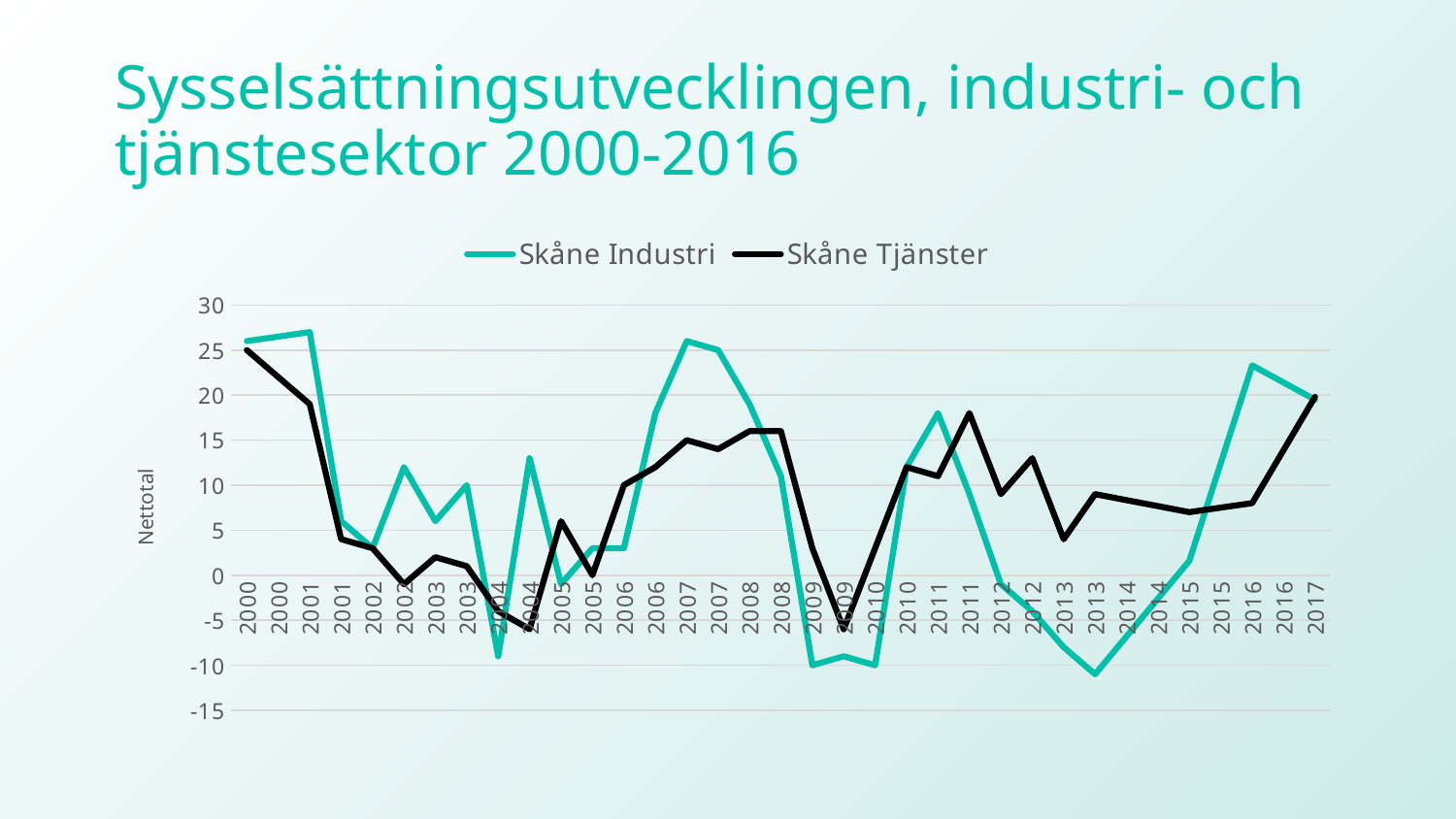
Is the value for Skåne Tjänster at the second 2004 point greater or less than 0? less At the first 2007 point, which series has the higher value, Skåne Industri or Skåne Tjänster? Skåne Industri Is the value for Skåne Tjänster at the second 2011 point greater or less than 15? greater What kind of chart is shown on the slide? line chart At the second 2013 point, which series has the higher value, Skåne Industri or Skåne Tjänster? Skåne Tjänster Is the value for Skåne Industri at the first 2007 point greater or less than 20? greater How many series does the legend list? 2 What is the title of the vertical axis? Nettotal Does the Skåne Tjänster line rise or fall from the first 2000 point to the second 2004 point? fall Which series is drawn with the black line? Skåne Tjänster